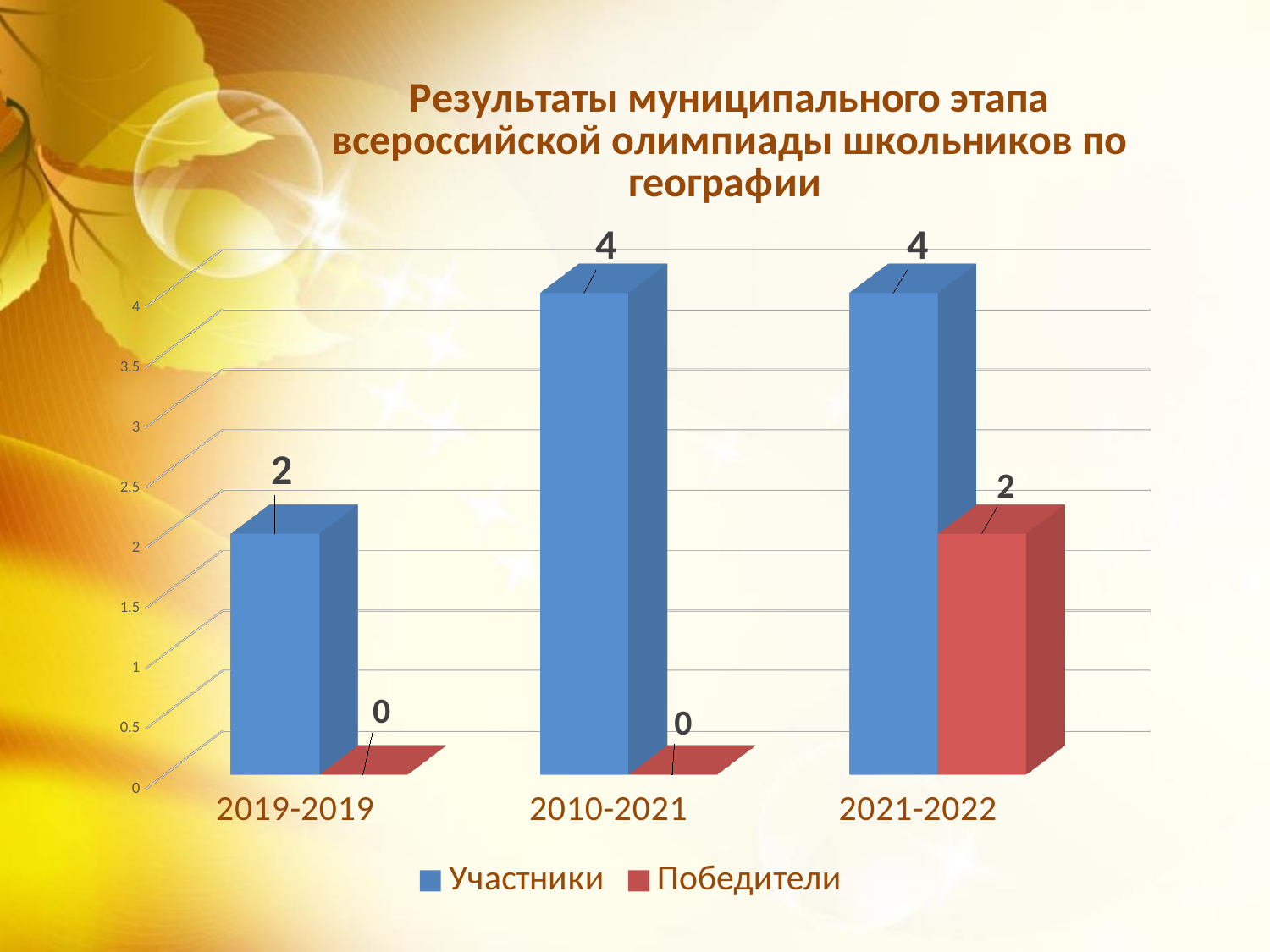
Which category has the highest value for Победители? 2021-2022 Which is larger: Участники in 2010-2021 or Участники in 2019-2019? Участники in 2010-2021 What is the value for Участники in 2019-2019? 2 What is the value for Участники in 2010-2021? 4 What kind of chart is shown on the slide? bar chart Which category has the lowest value for Участники? 2019-2019 What is the difference between Участники and Победители in 2021-2022? 2 What is the value for Победители in 2010-2021? 0 Which series is shown in red? Победители How many categories are shown on the x axis? 3 What is the value for Победители in 2021-2022? 2 How many series does the legend list? 2